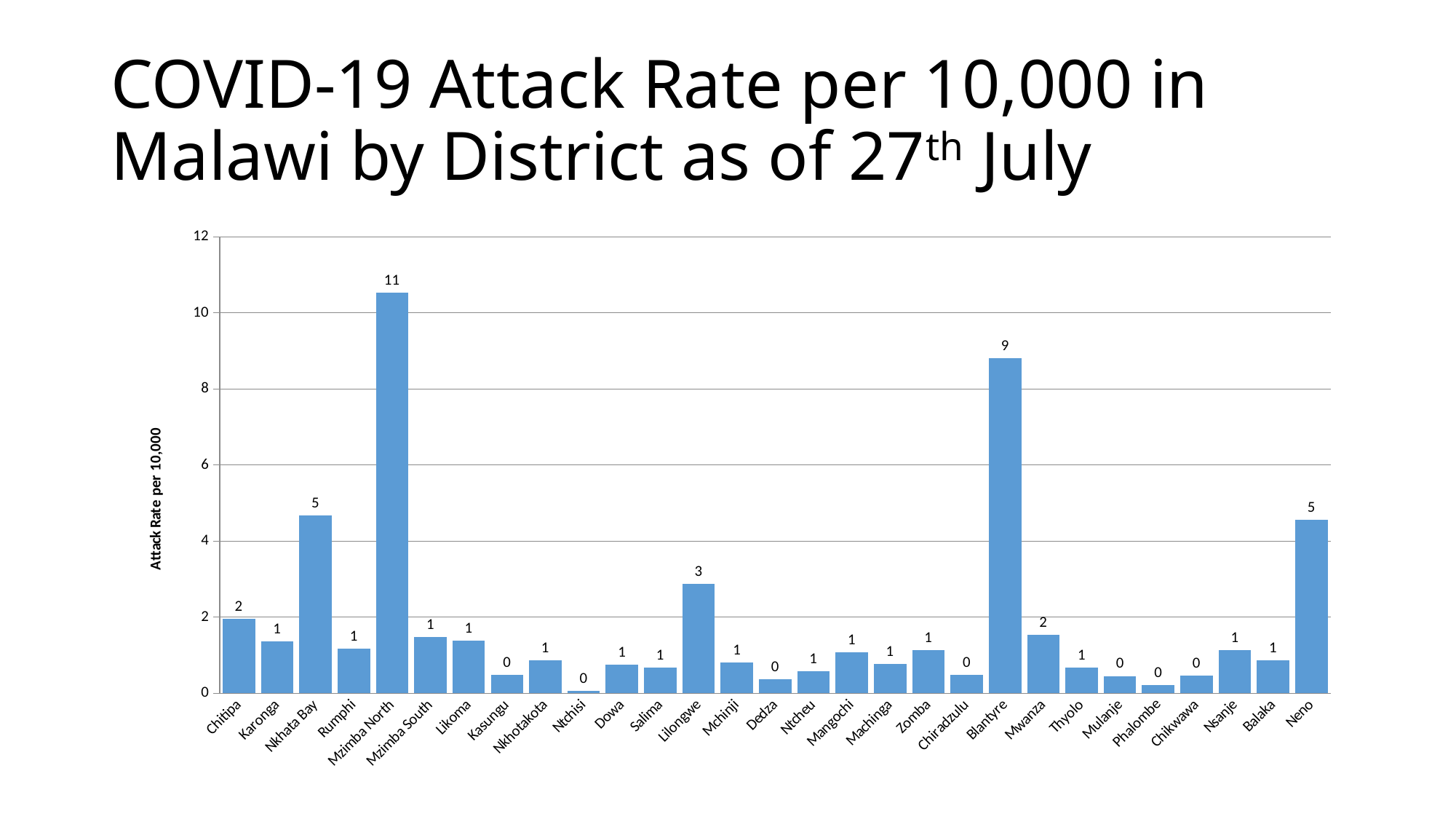
What kind of chart is shown on the slide? bar chart Is the value for Mzimba North greater or less than 10? greater What is the attack rate per 10,000 for Lilongwe? 3 What is the attack rate per 10,000 for Nkhata Bay? 5 Which district has the highest attack rate per 10,000? Mzimba North Which has a higher attack rate, Lilongwe or Mwanza? Lilongwe What is the attack rate per 10,000 for Blantyre? 9 How many districts are shown on the chart? 29 What is the label on the vertical axis of the chart? Attack Rate per 10,000 What is the difference between the attack rates of Mzimba North and Blantyre? 2 What is the attack rate per 10,000 for Mzimba North? 11 Is the value for Blantyre greater or less than 10? less